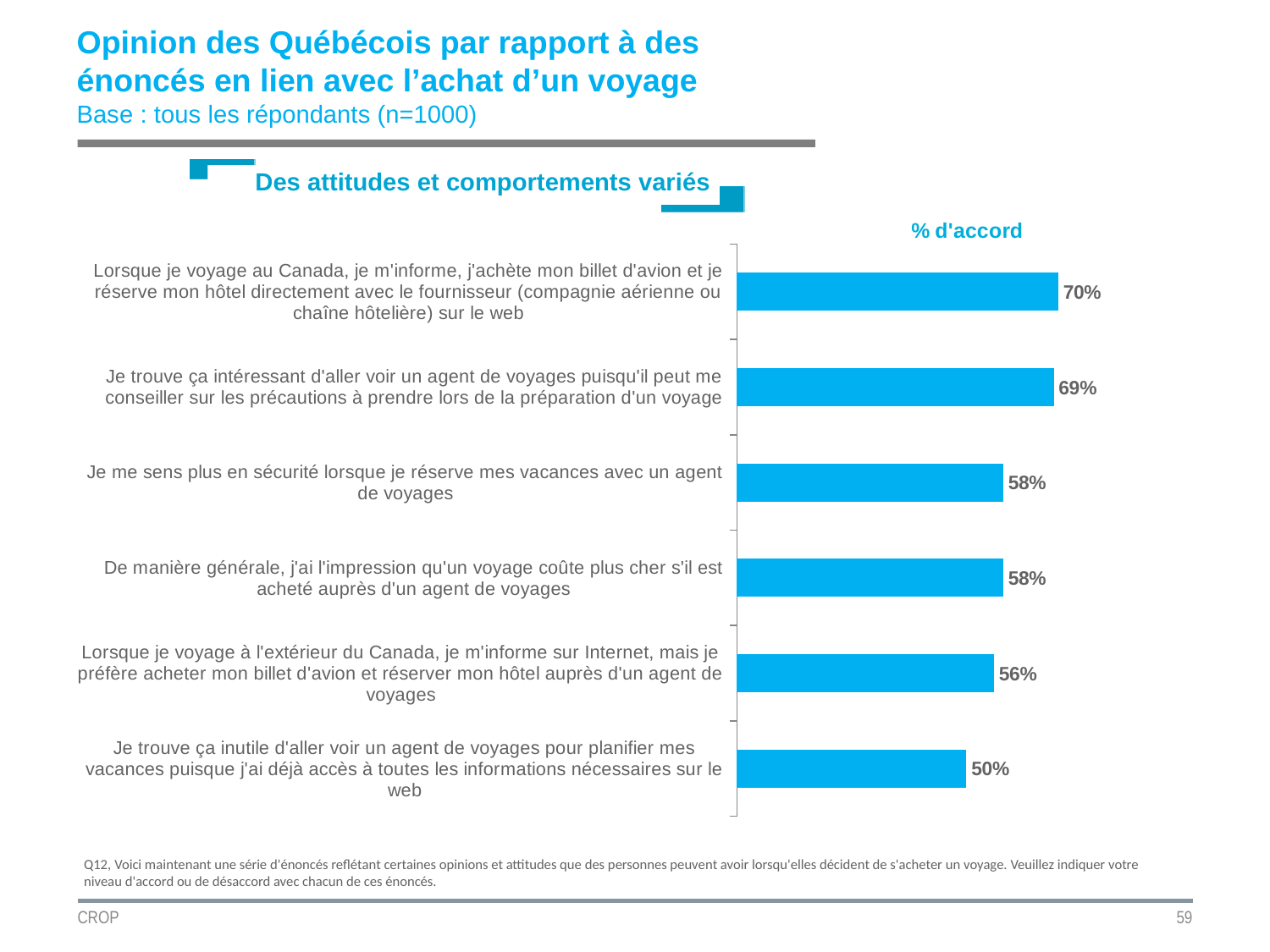
What percentage of respondents agree with the statement "Je me sens plus en sécurité lorsque je réserve mes vacances avec un agent de voyages"? 58% What is the difference in percentage points between the highest and lowest bars? 20 How many statements are shown in the chart? 6 What is the value shown for the statement "Je trouve ça inutile d'aller voir un agent de voyages pour planifier mes vacances puisque j'ai déjà accès à toutes les informations nécessaires sur le web"? 50% What is the base (number of respondents) indicated on the slide? n=1000 What is the difference between the agreement for the statement about finding it interesting to see a travel agent for advice on precautions (69%) and the statement about feeling safer booking with a travel agent (58%)? 11 What percentage agree that when travelling outside Canada they inform themselves on the Internet but prefer to buy their plane ticket and book their hotel through a travel agent? 56% What is the label shown above the bars indicating what the values represent? % d'accord Which statement has the highest percentage of agreement? Lorsque je voyage au Canada, je m'informe, j'achète mon billet d'avion et je réserve mon hôtel directement avec le fournisseur (compagnie aérienne ou chaîne hôtelière) sur le web Which has a higher agreement percentage: the statement about booking directly with the supplier on the web when travelling in Canada, or the statement about finding it useless to see a travel agent? The statement about booking directly with the supplier on the web when travelling in Canada What type of chart is used on this slide? Bar chart Which statement has the lowest percentage of agreement? Je trouve ça inutile d'aller voir un agent de voyages pour planifier mes vacances puisque j'ai déjà accès à toutes les informations nécessaires sur le web